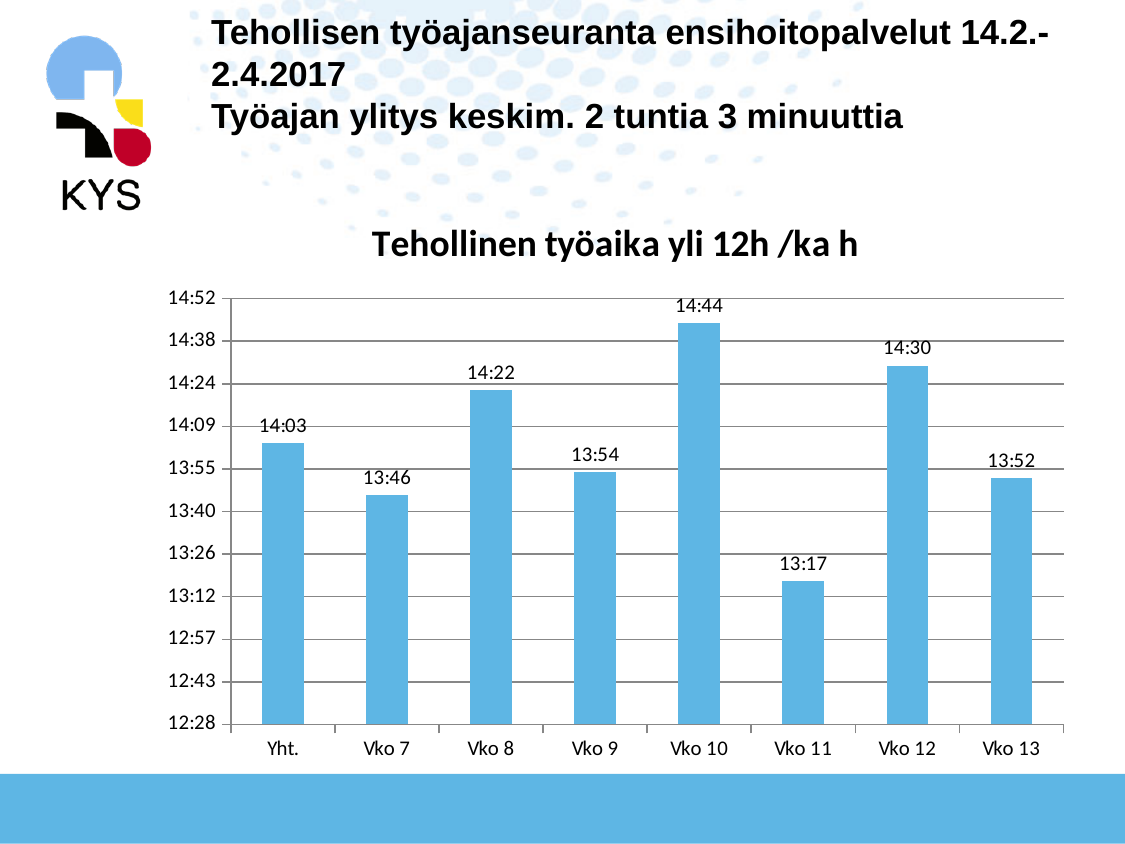
What is the title of the chart? Tehollinen työaika yli 12h /ka h Which is larger, the value for Vko 8 or the value for Vko 12? Vko 12 Which category has the highest value? Vko 10 Is the value for Vko 11 greater or less than 13:26? less Which category has the lowest value? Vko 11 What is the value for Vko 13? 13:52 Is the value for Vko 12 greater or less than 14:24? greater What is the value for Vko 10? 14:44 Which is larger, the value for Vko 7 or the value for Vko 9? Vko 9 How many categories are shown on the x axis? 8 What kind of chart is shown on the slide? bar chart What is the value for Yht.? 14:03